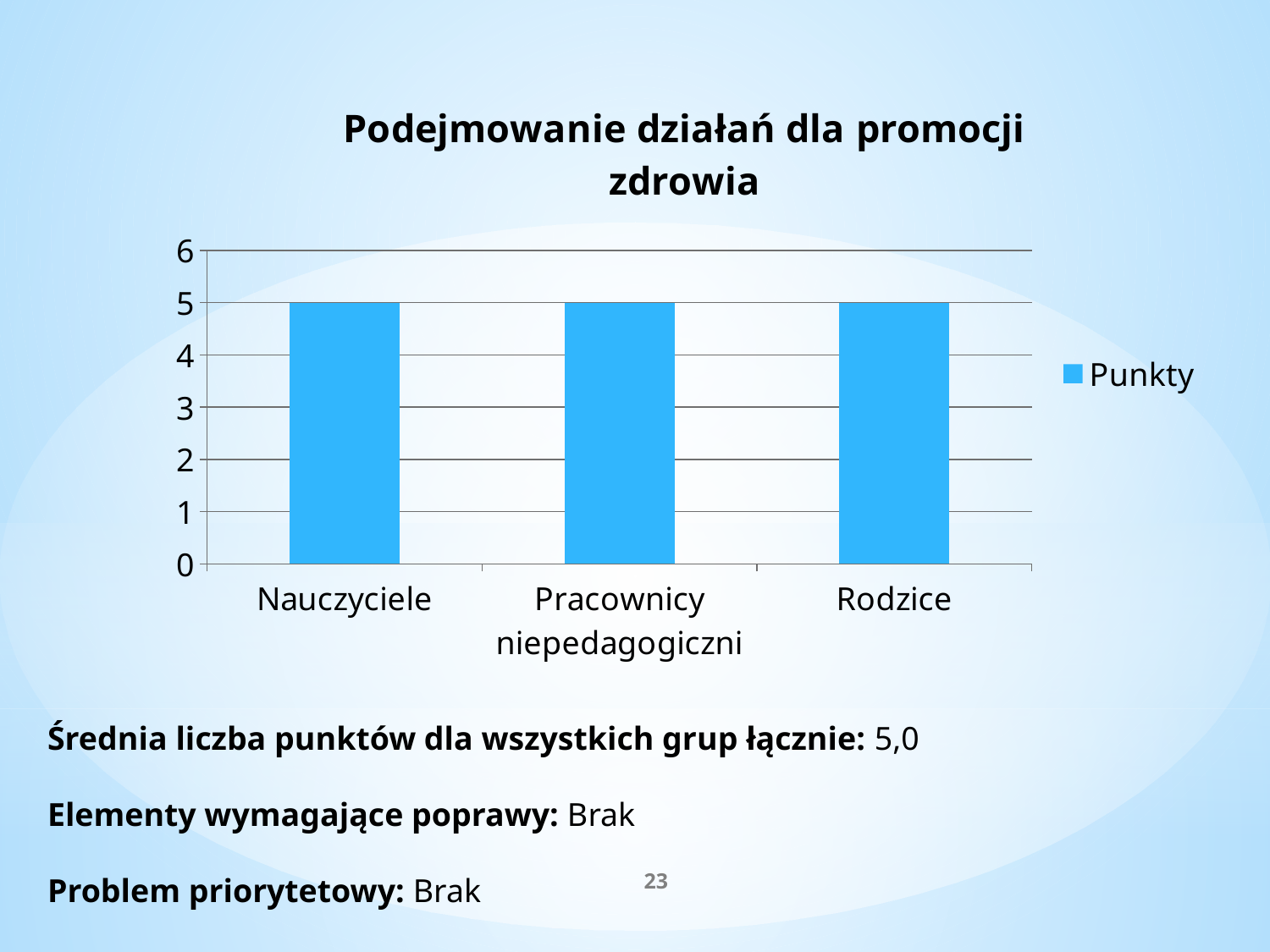
What is the value for Pracownicy niepedagogiczni? 5 Do the values rise, fall or stay the same across the categories from left to right? stay the same Is the value for Rodzice greater or less than 4? greater How many categories are shown on the x axis? 3 What is the difference between the values for Nauczyciele and Rodzice? 0 What is the title of the chart? Podejmowanie działań dla promocji zdrowia What is the value for Nauczyciele? 5 Is the value for Nauczyciele greater or less than 6? less How many series does the legend list? 1 What is the value for Rodzice? 5 What kind of chart is shown on the slide? bar chart What series name is shown in the legend? Punkty